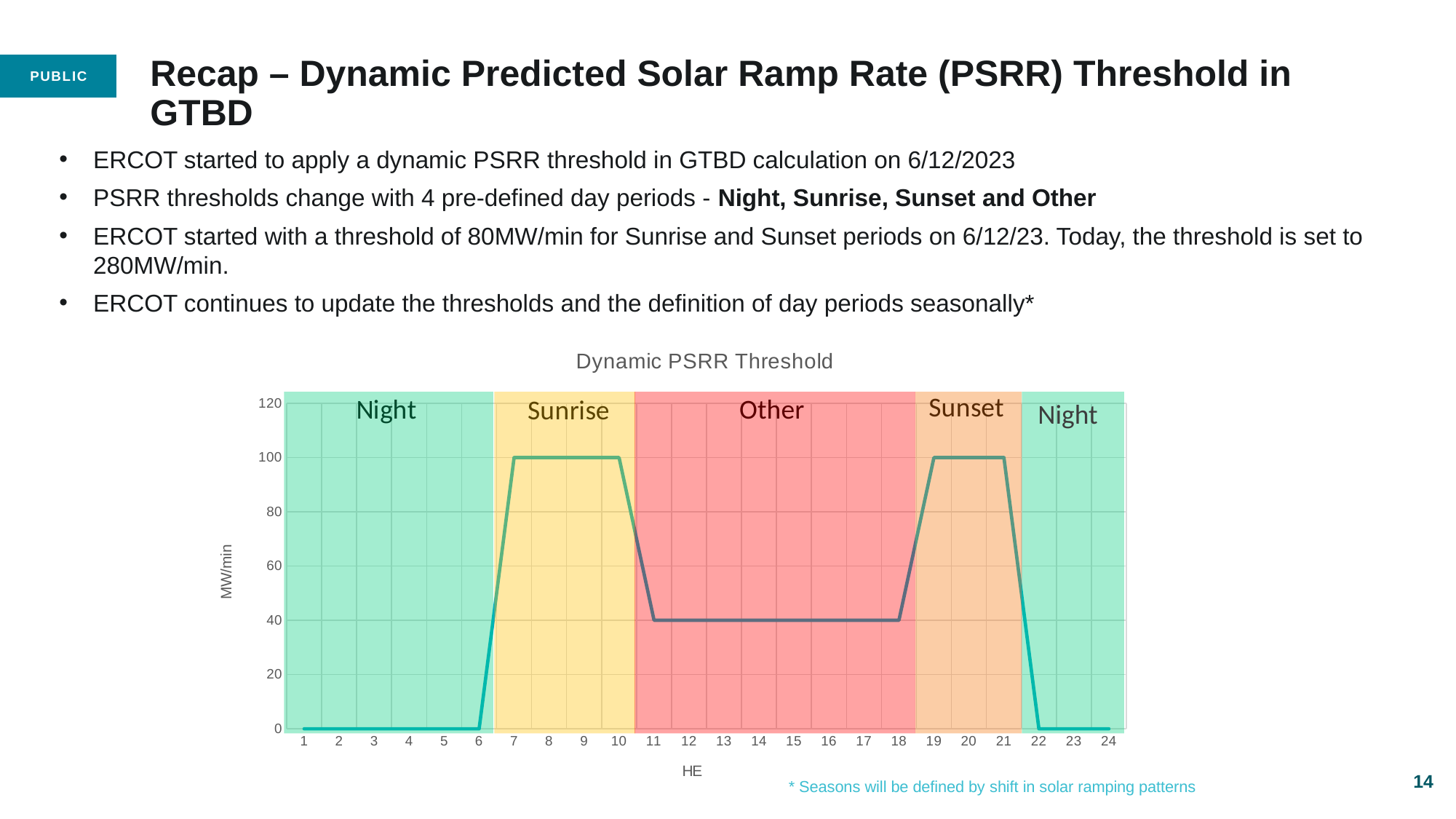
What is the difference between the threshold at HE 9 and the threshold at HE 15? 60 What is the title of the chart? Dynamic PSRR Threshold Does the threshold rise or fall between HE 10 and HE 11? fall What is the y-axis label of the chart? MW/min What kind of chart is shown on the slide? line chart What is the threshold value at HE 3? 0 Which is larger, the threshold at HE 12 or the threshold at HE 19? HE 19 What is the threshold value at HE 20? 100 What is the threshold value at HE 8? 100 Is the threshold value at HE 16 greater or less than 60? less What is the threshold value at HE 14? 40 How many hour-ending (HE) points are shown on the x axis? 24